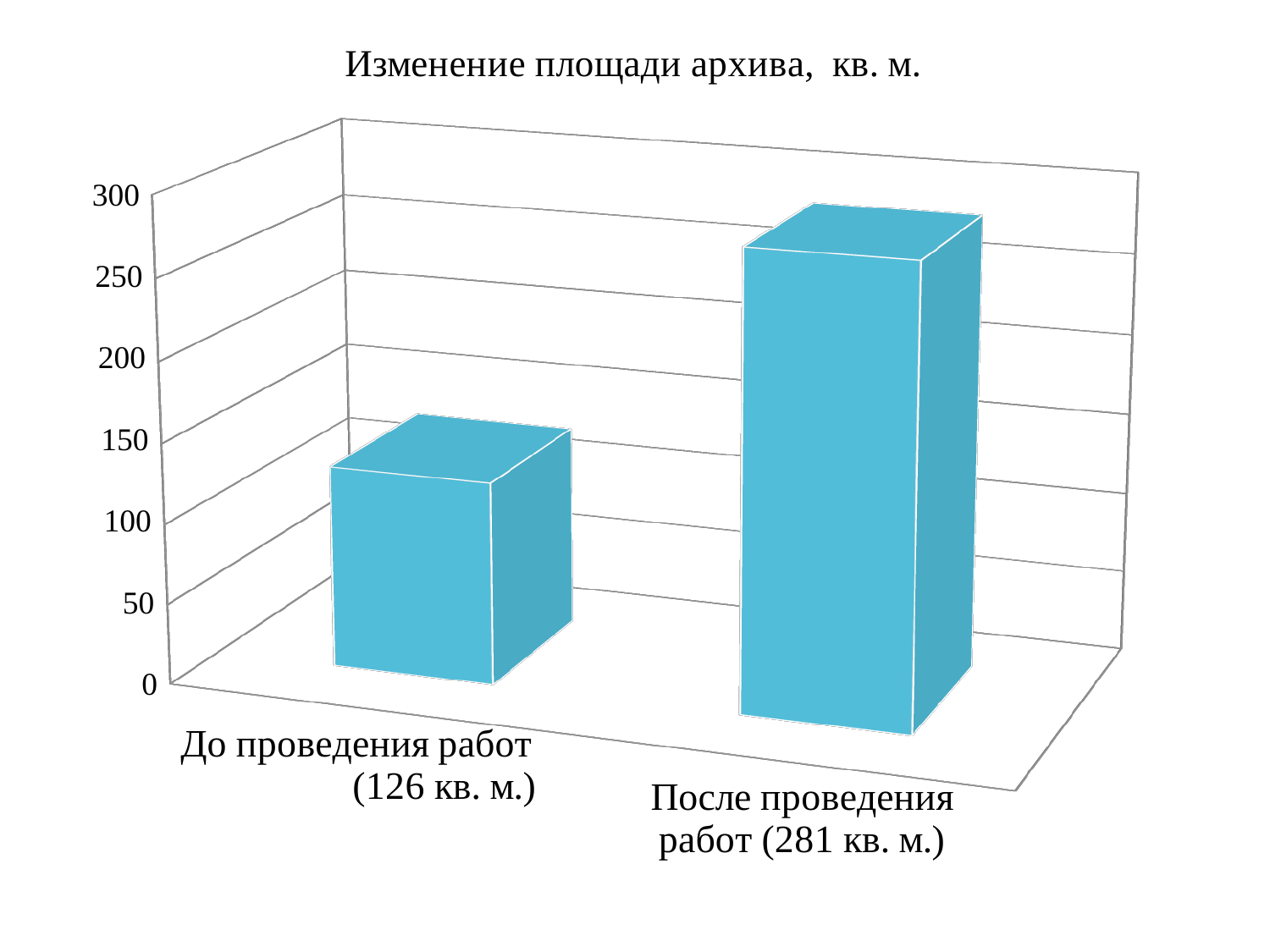
Is the value for До проведения работ greater or less than 150? less What is the title of the chart? Изменение площади архива, кв. м. Is the value for После проведения работ greater or less than 250? greater Which is larger: the area before the works or the area after the works? После проведения работ Do the values rise or fall from left to right along the x axis? rise Which category has the highest value? После проведения работ Which category has the lowest value? До проведения работ What kind of chart is shown on the slide? bar chart What is the archive area after the works (После проведения работ)? 281 кв. м. What is the archive area before the works (До проведения работ)? 126 кв. м. By how much did the archive area increase after the works compared with before? 155 кв. м. How many categories (bars) does the chart show? 2